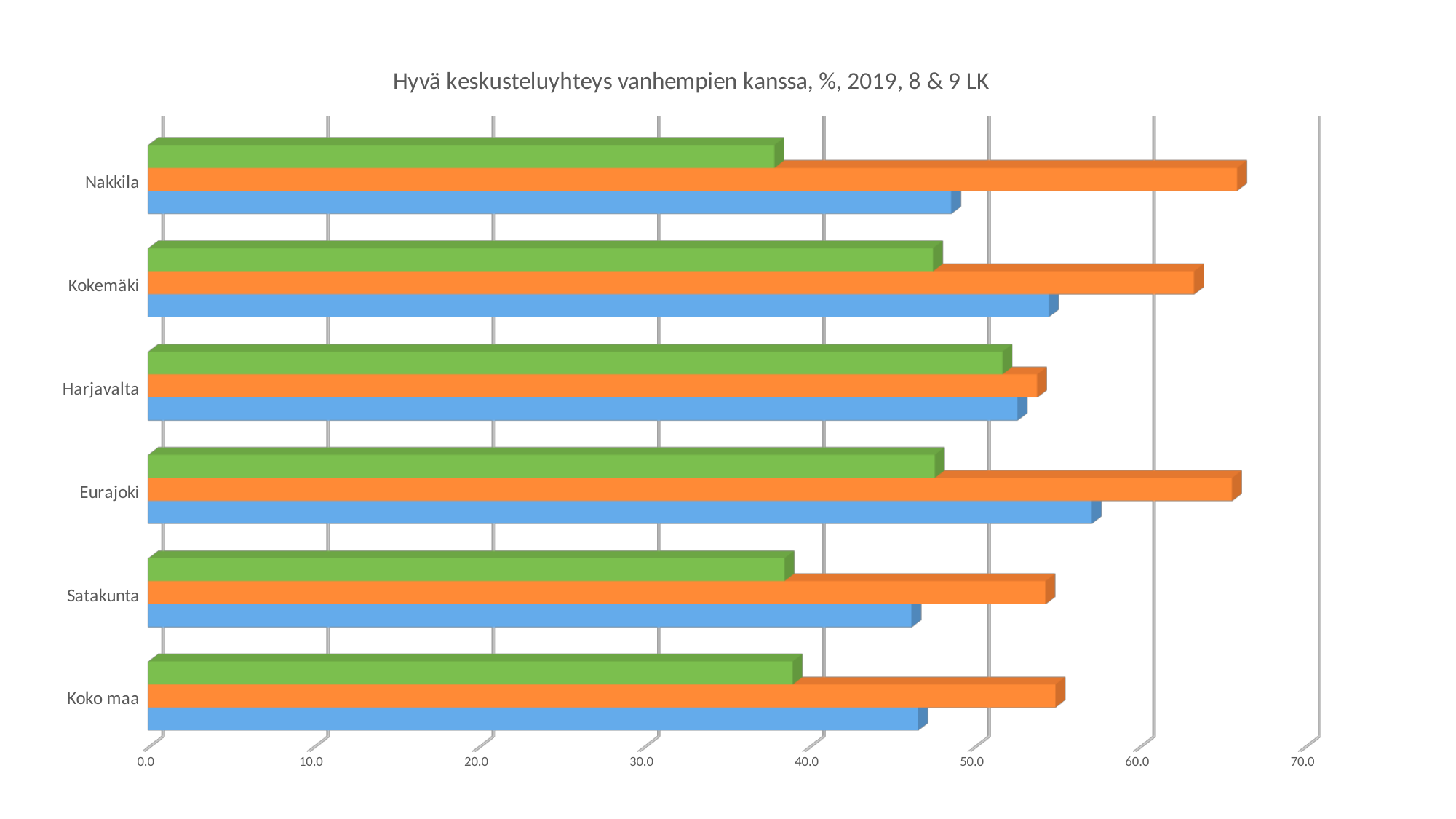
Is the value of the blue bar for Koko maa greater or less than 50? less What is the title of the chart? Hyvä keskusteluyhteys vanhempien kanssa, %, 2019, 8 & 9 LK Is the value of the orange bar for Nakkila greater or less than 60? greater Which category has the longest blue bar? Eurajoki How many data series (bars per category) does the chart show? 3 What kind of chart is shown on the slide? bar chart Which category has the longest green bar? Harjavalta For Eurajoki, which is larger: the orange bar or the green bar? the orange bar How many categories are shown on the vertical axis of the chart? 6 Is the value of the blue bar for Kokemäki greater or less than 50? greater